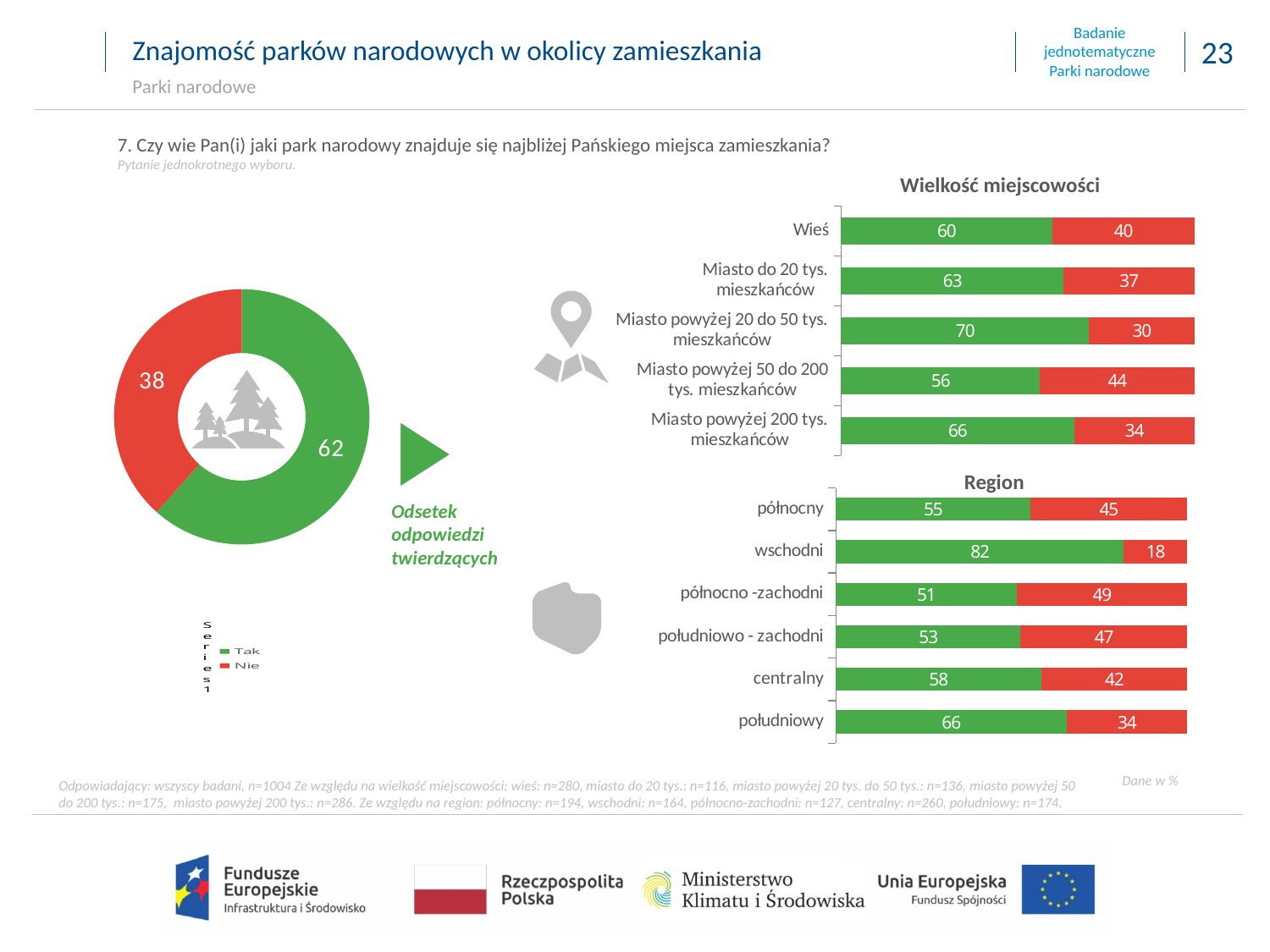
What type of chart is the "Region" chart? Stacked bar chart In the "Region" chart, which has the larger green (Tak) value: "centralny" or "południowy"? południowy In the donut chart on the left, what is the value for "Tak"? 62 In the "Wielkość miejscowości" chart, how many categories are shown? 5 In the "Region" chart, which region has the highest green (Tak) value? wschodni In the donut chart on the left, what is the value for "Nie"? 38 In the "Region" chart, what is the red (Nie) value for "wschodni"? 18 In the "Region" chart, how many regions are shown? 6 In the "Wielkość miejscowości" chart, which category has the lowest green (Tak) value? Miasto powyżej 50 do 200 tys. mieszkańców In the "Region" chart, what is the difference between the green (Tak) values for "wschodni" and "północno -zachodni"? 31 In the "Wielkość miejscowości" chart, what is the green (Tak) value for "Wieś"? 60 In the "Wielkość miejscowości" chart, which category has the highest green (Tak) value? Miasto powyżej 20 do 50 tys. mieszkańców